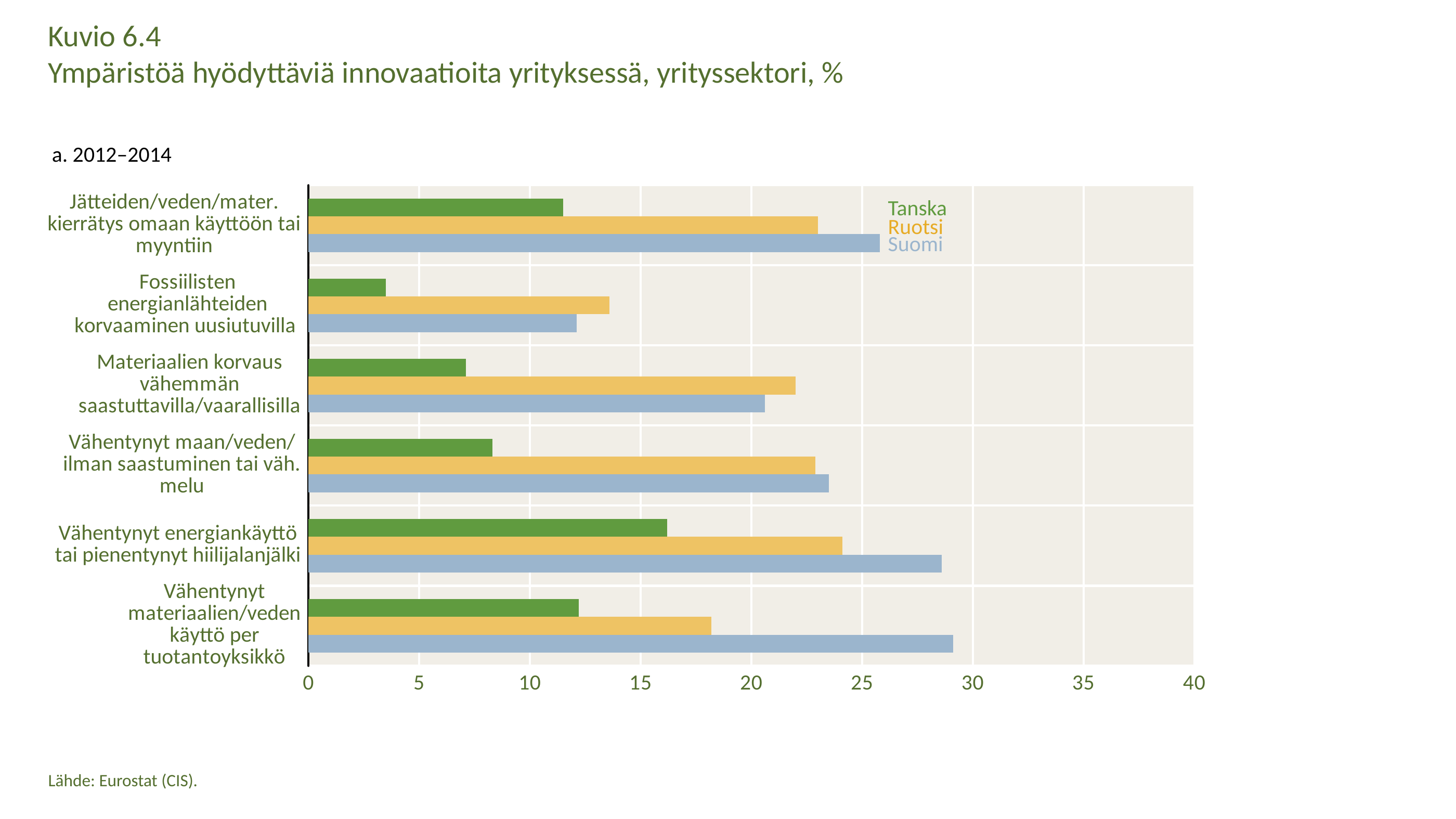
For which category is the value for Ruotsi the lowest? Fossiilisten energianlähteiden korvaaminen uusiutuvilla How many innovation categories are shown on the y axis? 6 For which category is the value for Tanska the highest? Vähentynyt energiankäyttö tai pienentynyt hiilijalanjälki For which category is the value for Tanska the lowest? Fossiilisten energianlähteiden korvaaminen uusiutuvilla Is the value for Tanska in 'Fossiilisten energianlähteiden korvaaminen uusiutuvilla' greater or less than 5? less What kind of chart is shown on the slide? bar chart In 'Jätteiden/veden/mater. kierrätys omaan käyttöön tai myyntiin', which is larger, the value for Suomi or the value for Tanska? Suomi Is the value for Suomi in 'Vähentynyt energiankäyttö tai pienentynyt hiilijalanjälki' greater or less than 25? greater Which colour represents Suomi in the chart? blue Which time period does the chart cover, according to the label above it? 2012–2014 How many series (countries) does the legend list? 3 Is the value for Ruotsi in 'Materiaalien korvaus vähemmän saastuttavilla/vaarallisilla' greater or less than 20? greater